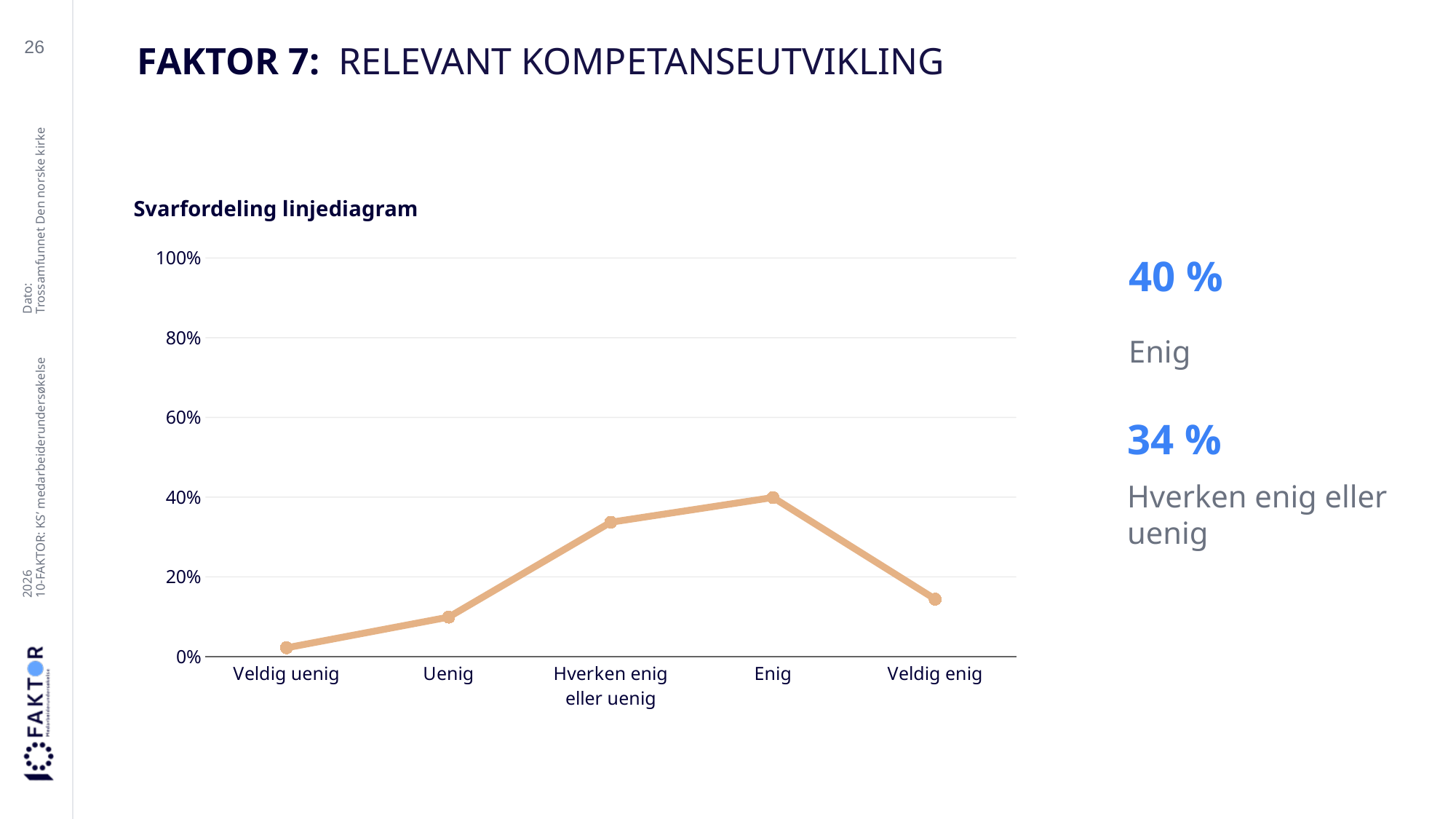
Which category has the highest value? Enig Which category has the lowest value? Veldig uenig What is the difference between the values for Enig and Hverken enig eller uenig? 6 % What is the value for Hverken enig eller uenig? 34 % What kind of chart is shown on the slide? line chart What is the title of the chart? Svarfordeling linjediagram Which is larger, the value for Hverken enig eller uenig or the value for Veldig enig? Hverken enig eller uenig What is the value for Enig? 40 % Is the value for Uenig greater or less than 20%? less How many categories are plotted along the x axis of the chart? 5 Is the value for Veldig enig greater or less than 20%? less Does the line rise or fall from Enig to Veldig enig? falls